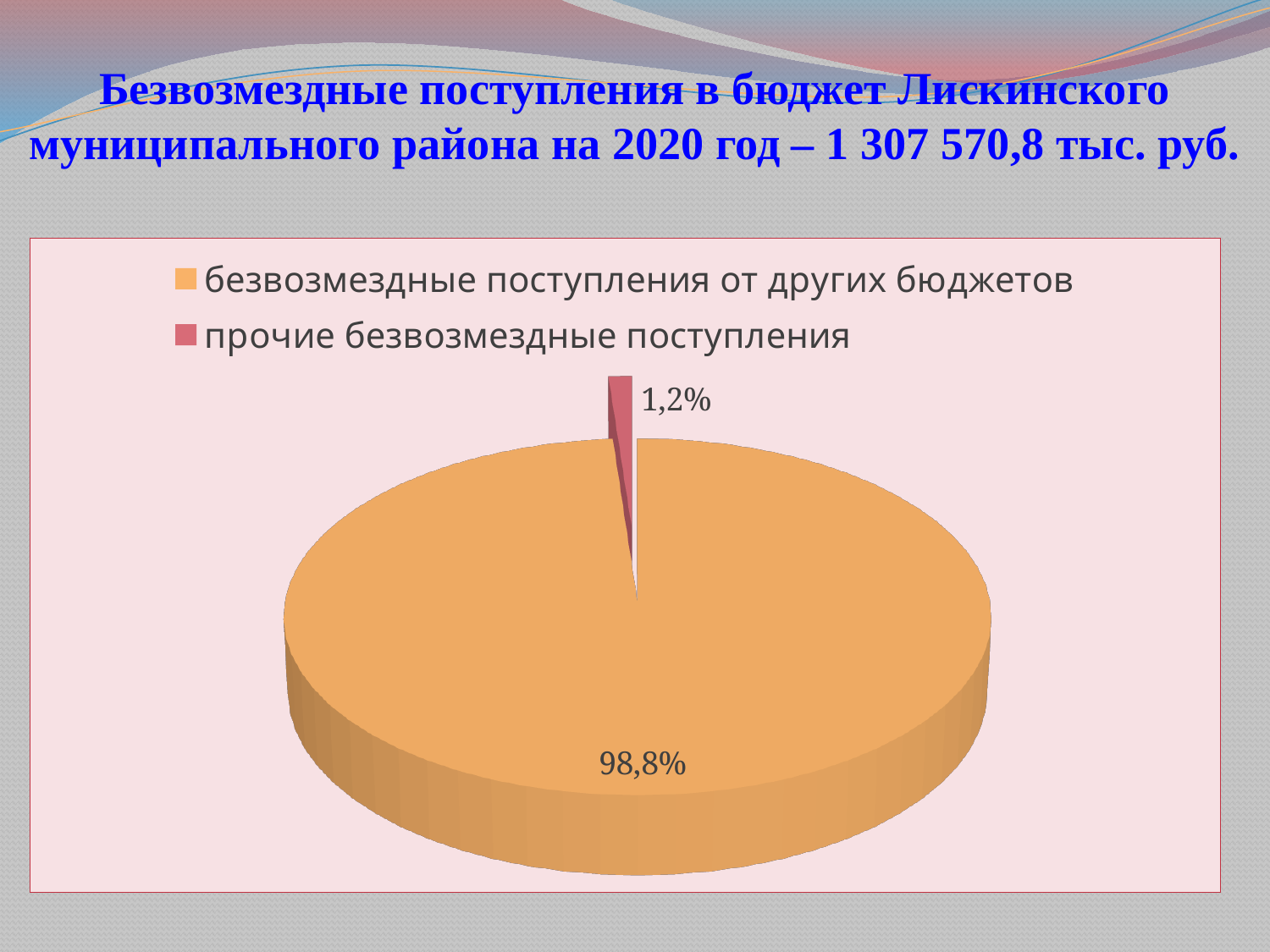
Which is larger: the slice for 'безвозмездные поступления от других бюджетов' or the slice for 'прочие безвозмездные поступления'? безвозмездные поступления от других бюджетов Which slice of the pie is the smallest? прочие безвозмездные поступления What is the difference in percentage points between the two slices of the pie? 97,6 Which slice of the pie is the largest? безвозмездные поступления от других бюджетов What kind of chart is shown on the slide? pie chart What total amount of gratuitous receipts for 2020 is stated in the slide title? 1 307 570,8 тыс. руб. What share of the pie is labelled for 'безвозмездные поступления от других бюджетов'? 98,8% How many entries does the legend list? 2 How many slices does the pie chart have? 2 What colour is the slice for 'прочие безвозмездные поступления'? red What share of the pie is labelled for 'прочие безвозмездные поступления'? 1,2%